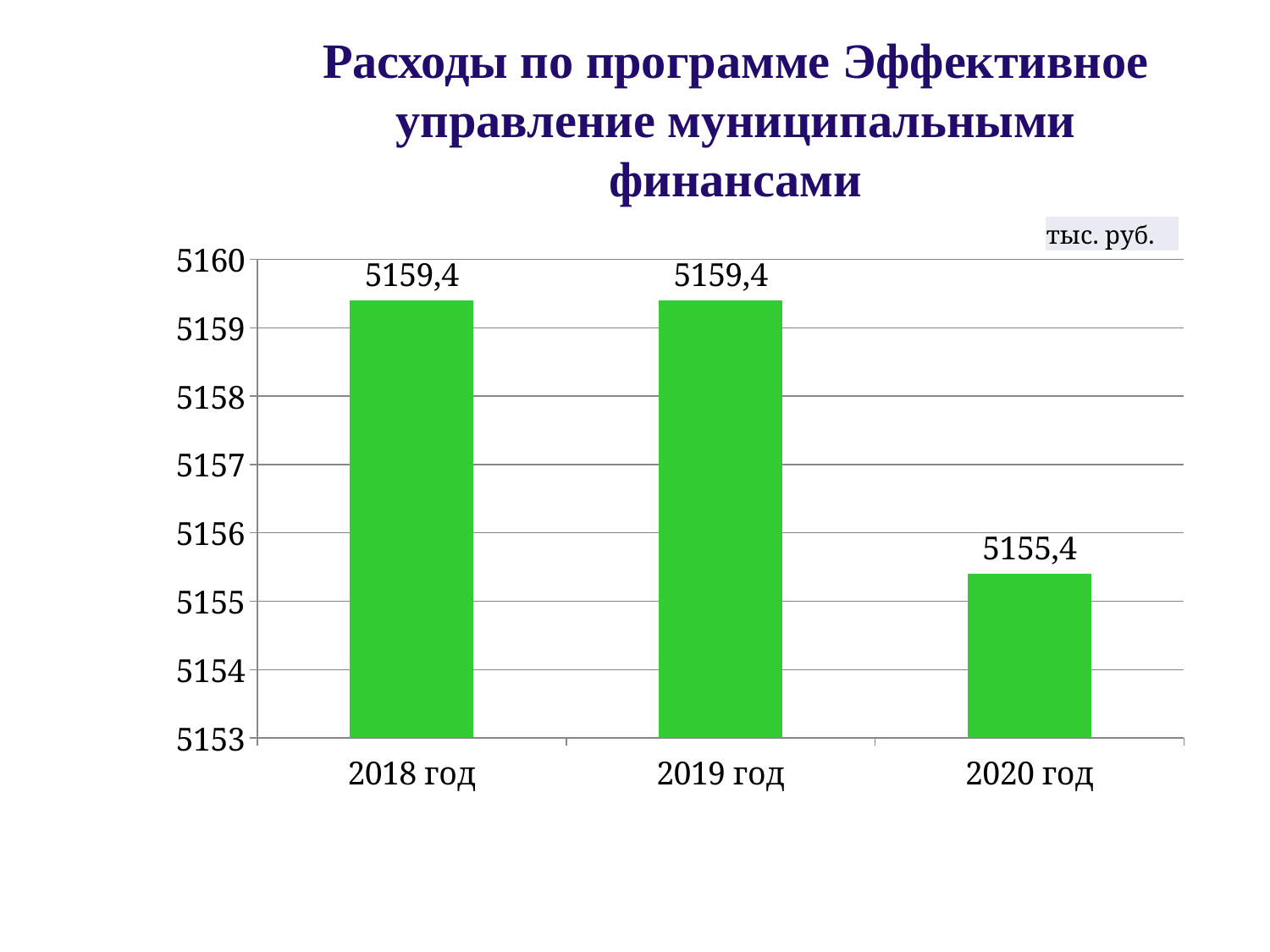
Which year has the lowest value? 2020 год What is the value for 2018 год? 5159,4 Do the values rise or fall from 2019 год to 2020 год? fall Which is larger, the value for 2018 год or the value for 2020 год? 2018 год How many years are shown on the x axis? 3 What is the value for 2020 год? 5155,4 Is the value for 2020 год greater or less than 5156? less What is the value for 2019 год? 5159,4 What kind of chart is shown on the slide? bar chart Is the value for 2018 год greater or less than 5159? greater What unit is indicated for the values on the chart? тыс. руб. What is the difference between the values for 2019 год and 2020 год? 4